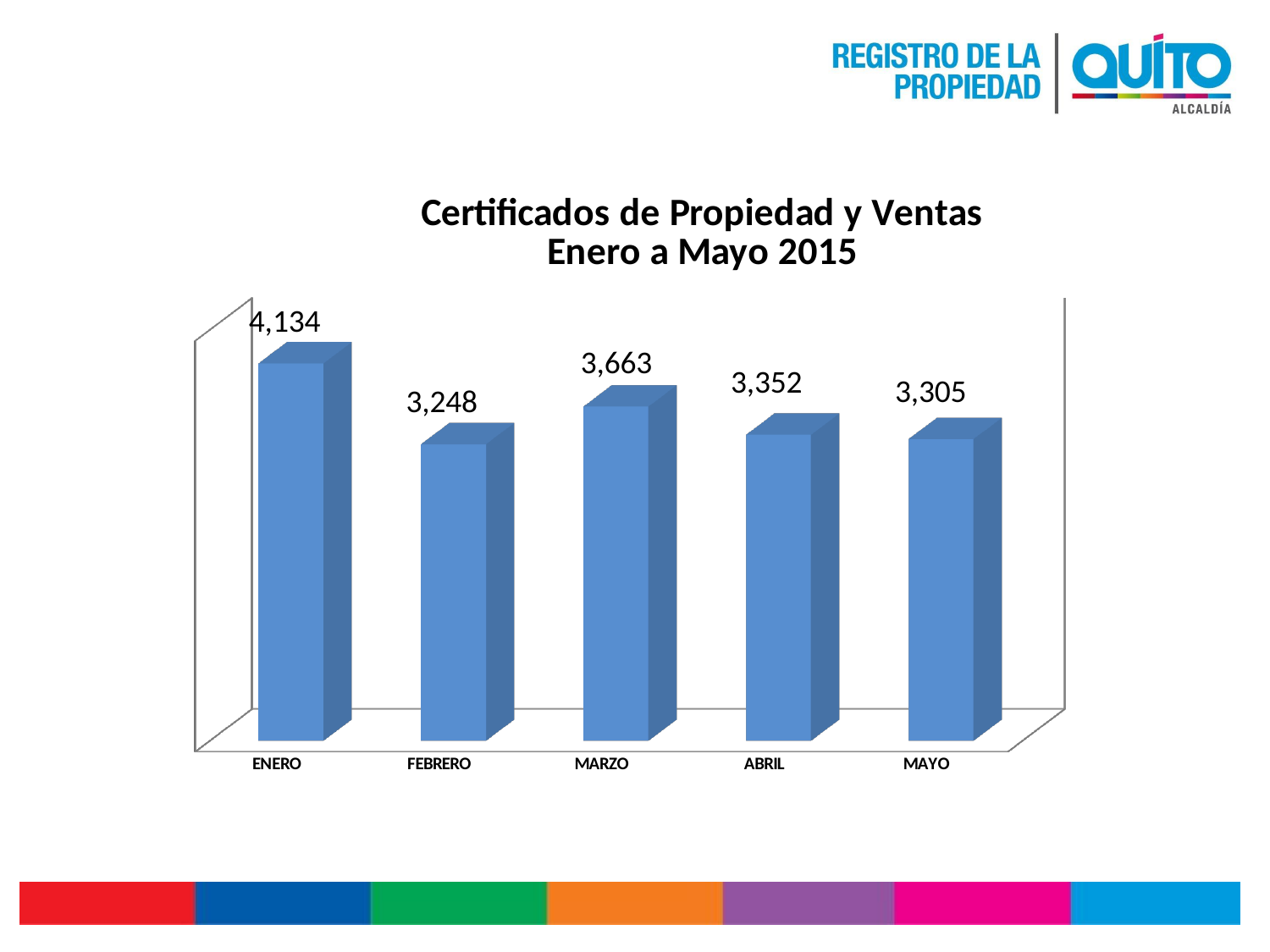
What is the difference between the values for ENERO and FEBRERO? 886 Which is larger, the value for ABRIL or the value for MAYO? ABRIL How many months are shown on the chart? 5 What is the title of the chart? Certificados de Propiedad y Ventas Enero a Mayo 2015 What is the value for FEBRERO? 3,248 What is the value for MARZO? 3,663 What kind of chart is shown on the slide? bar chart What is the value for MAYO? 3,305 What is the value for ENERO? 4,134 Which month has the lowest value? FEBRERO Which month has the highest value? ENERO What is the difference between the values for MARZO and ABRIL? 311